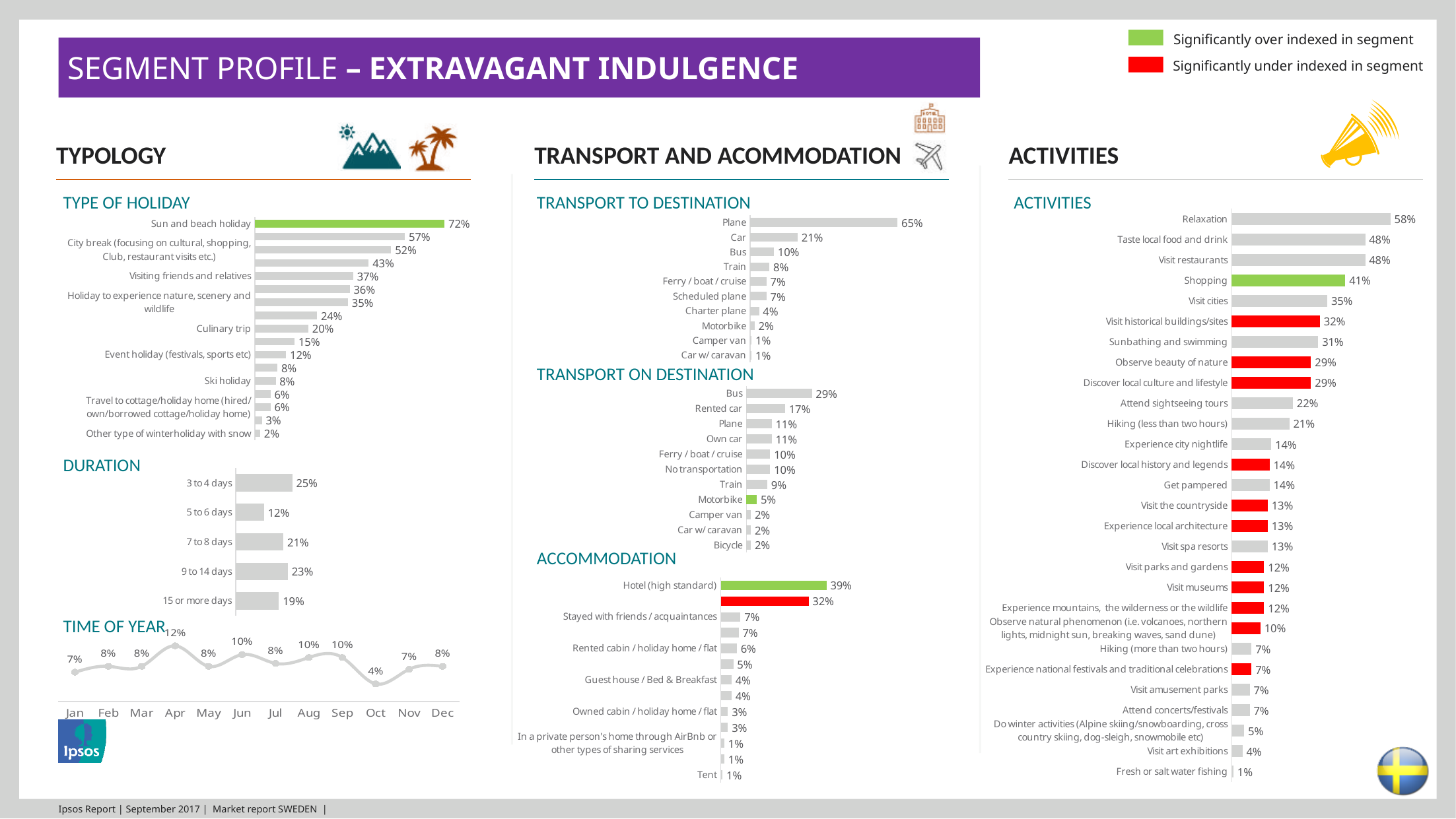
In the Accommodation chart, what is the value for Hotel (high standard)? 39% How many categories are shown in the Transport to Destination chart? 10 In the Duration chart, which duration has the lowest value? 5 to 6 days In the Transport to Destination chart, what is the value for Plane? 65% In the Activities chart, what is the value for Shopping? 41% In the Time of Year chart, which month has the lowest value? Oct In the Time of Year chart, what is the value for Apr? 12% What type of chart is the Time of Year chart? Line chart In the Activities chart, which activity has the highest value? Relaxation In the Transport on Destination chart, which is larger, Bus or Rented car? Bus In the Duration chart, what is the difference between the values for 3 to 4 days and 15 or more days? 6% How many months are plotted in the Time of Year chart? 12